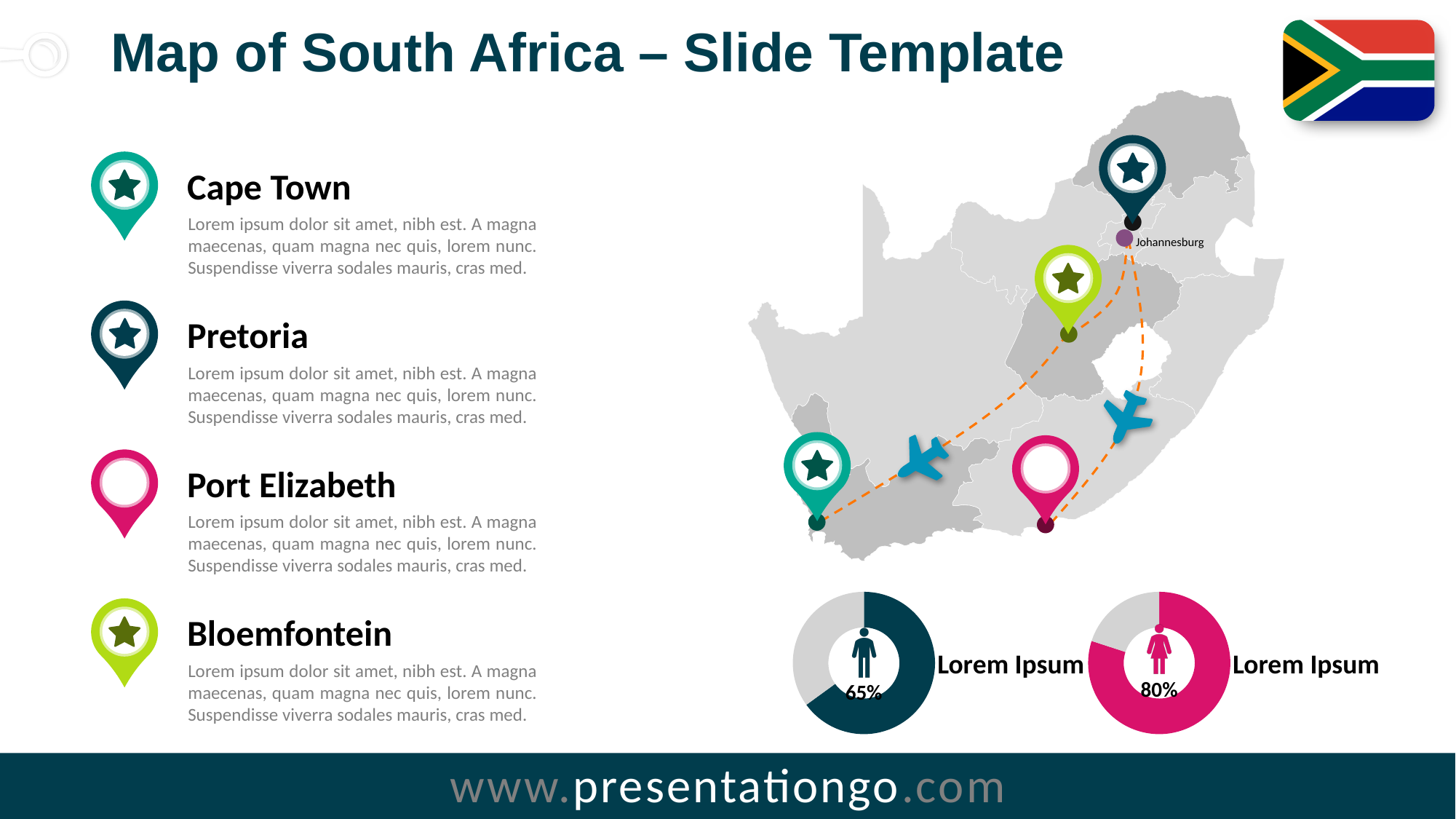
How many donut charts are shown on the slide? 2 What colour is the filled portion of the left donut chart? Dark teal What kind of chart is used for the two figures at the bottom of the slide? Donut chart Is the value on the left donut chart greater or less than 50%? greater Which of the two donut charts at the bottom shows the larger value, the left one or the right one? The right one What is the difference between the values shown on the right donut chart and the left donut chart? 15% What share of the left donut chart is not filled by the 65% segment? 35% What share of the right donut chart is not filled by the 80% segment? 20% What value is shown on the right donut chart at the bottom of the slide? 80% What colour is the filled portion of the right donut chart? Pink What value is shown on the left donut chart at the bottom of the slide? 65% Is the value on the right donut chart greater or less than 75%? greater